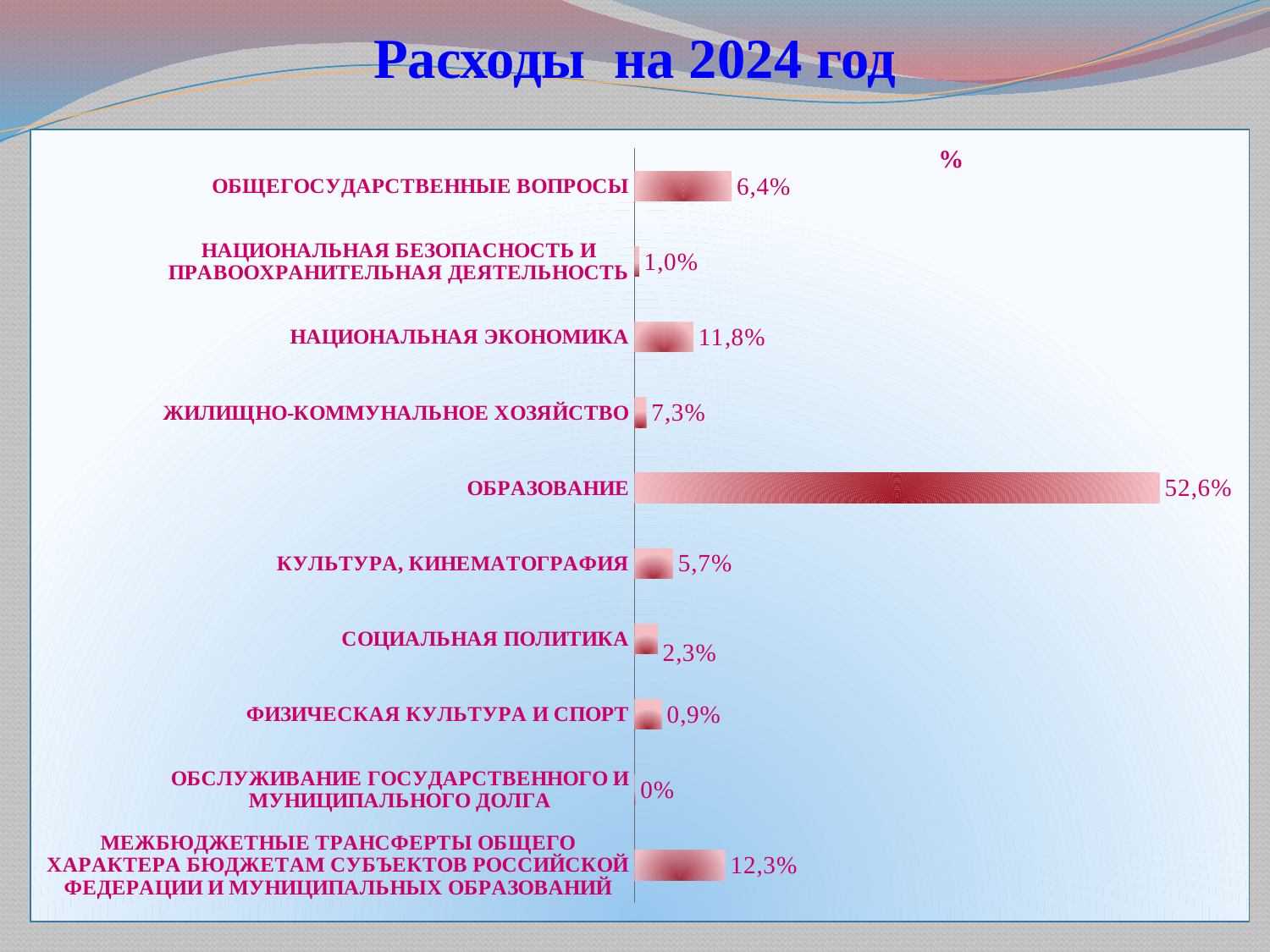
What is the value for НАЦИОНАЛЬНАЯ ЭКОНОМИКА? 11,8% What is the value for МЕЖБЮДЖЕТНЫЕ ТРАНСФЕРТЫ ОБЩЕГО ХАРАКТЕРА БЮДЖЕТАМ СУБЪЕКТОВ РОССИЙСКОЙ ФЕДЕРАЦИИ И МУНИЦИПАЛЬНЫХ ОБРАЗОВАНИЙ? 12,3% What is the value for ОБРАЗОВАНИЕ? 52,6% What is the difference between the values for ОБРАЗОВАНИЕ and НАЦИОНАЛЬНАЯ ЭКОНОМИКА? 40,8 percentage points What is the difference between the values for НАЦИОНАЛЬНАЯ ЭКОНОМИКА and ОБЩЕГОСУДАРСТВЕННЫЕ ВОПРОСЫ? 5,4 percentage points What is the title of the slide? Расходы на 2024 год Which category has the lowest value? ОБСЛУЖИВАНИЕ ГОСУДАРСТВЕННОГО И МУНИЦИПАЛЬНОГО ДОЛГА What is the value for ФИЗИЧЕСКАЯ КУЛЬТУРА И СПОРТ? 0,9% Which category has the highest value? ОБРАЗОВАНИЕ Which is larger, the value for СОЦИАЛЬНАЯ ПОЛИТИКА or the value for КУЛЬТУРА, КИНЕМАТОГРАФИЯ? КУЛЬТУРА, КИНЕМАТОГРАФИЯ How many categories are shown in the chart? 10 What kind of chart is shown on the slide? Bar chart